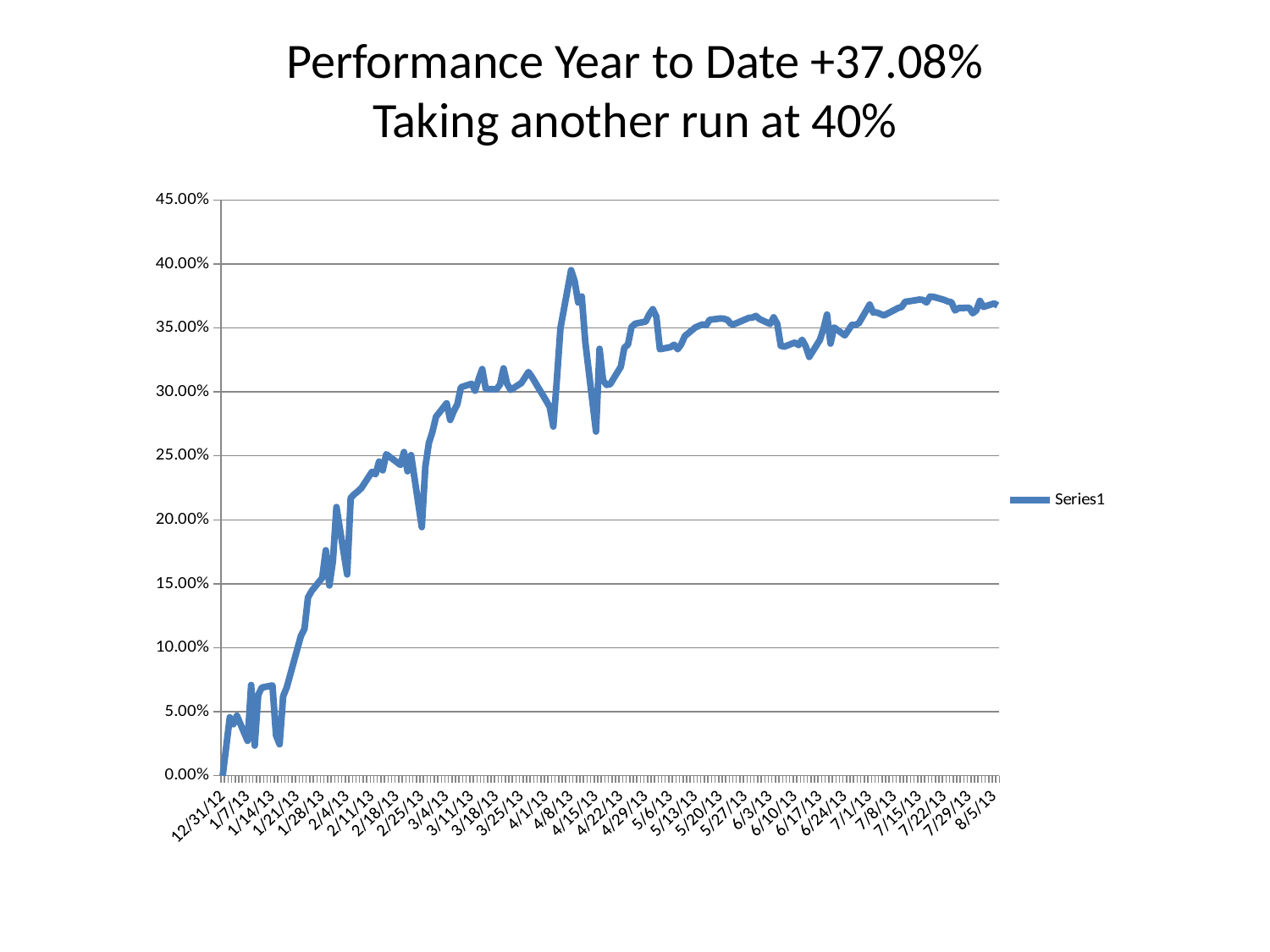
What is the name of the series shown in the legend? Series1 Does the line ever go above the 40.00% gridline? no Overall, does the line rise or fall from 12/31/12 to 8/5/13? rise Is the value for 2/4/13 greater or less than 25%? less What kind of chart is shown on the slide? line chart How many series does the legend list? 1 Is the value for 1/7/13 greater or less than 10%? less What is the first date label on the x axis? 12/31/12